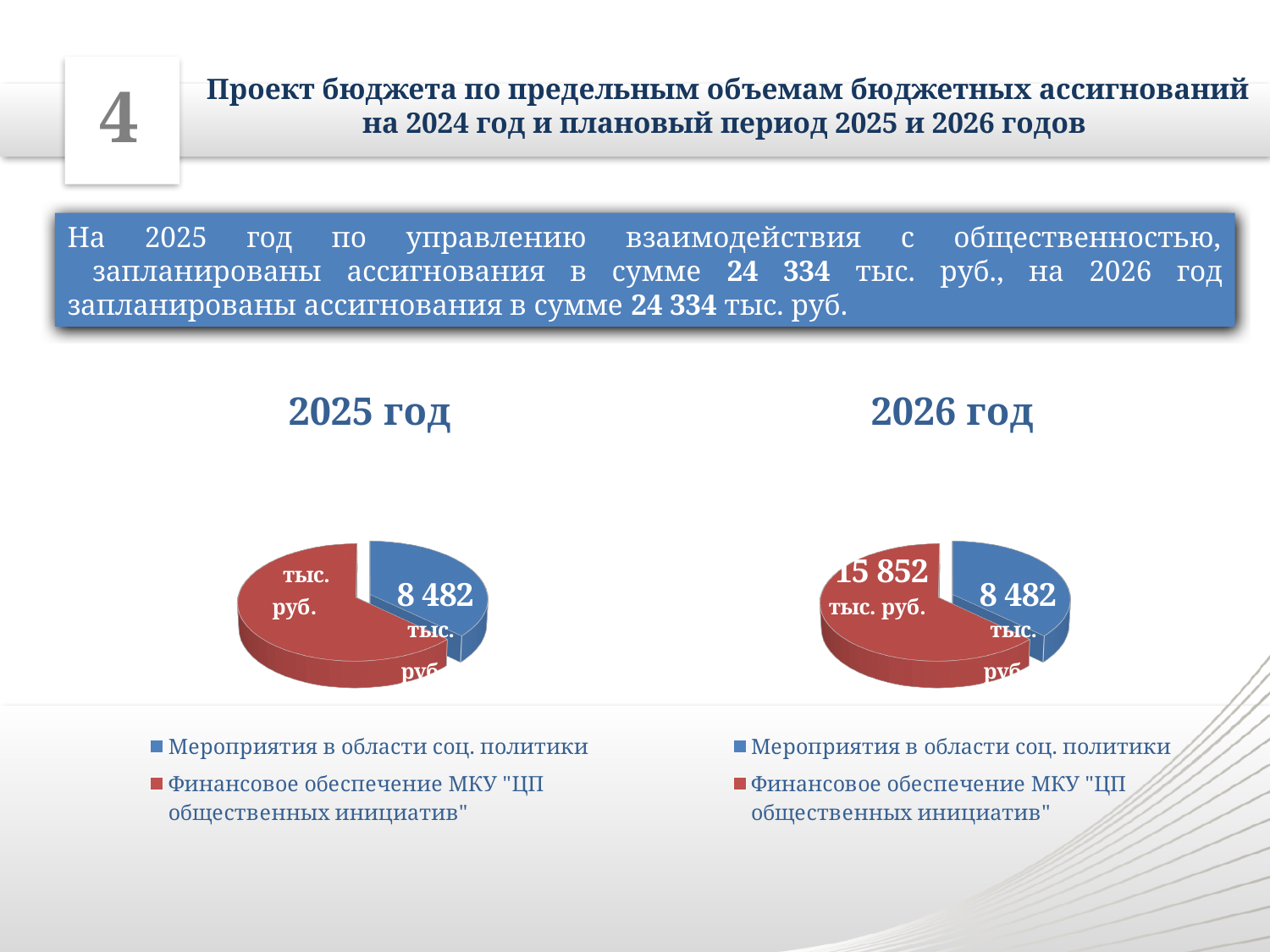
In the "2025 год" chart, which category has the smallest slice? Мероприятия в области соц. политики In the "2026 год" chart, which is larger: "Мероприятия в области соц. политики" or "Финансовое обеспечение МКУ "ЦП общественных инициатив""? Финансовое обеспечение МКУ "ЦП общественных инициатив" In the "2026 год" chart, what is the value for "Мероприятия в области соц. политики"? 8 482 тыс. руб. In the "2026 год" chart, what is the total of the two slices? 24 334 тыс. руб. How many entries does the legend of the "2026 год" chart list? 2 In the "2026 год" chart, what is the value for "Финансовое обеспечение МКУ "ЦП общественных инициатив""? 15 852 тыс. руб. In the "2026 год" chart, which category has the largest slice? Финансовое обеспечение МКУ "ЦП общественных инициатив" In the "2026 год" chart, what is the difference between "Финансовое обеспечение МКУ "ЦП общественных инициатив"" and "Мероприятия в области соц. политики"? 7 370 тыс. руб. In the "2025 год" chart, what colour is the slice for "Мероприятия в области соц. политики"? Blue How many slices does the "2025 год" pie chart have? 2 What kind of chart is used for the "2025 год" chart? Pie chart In the "2025 год" chart, what is the value for "Мероприятия в области соц. политики"? 8 482 тыс. руб.